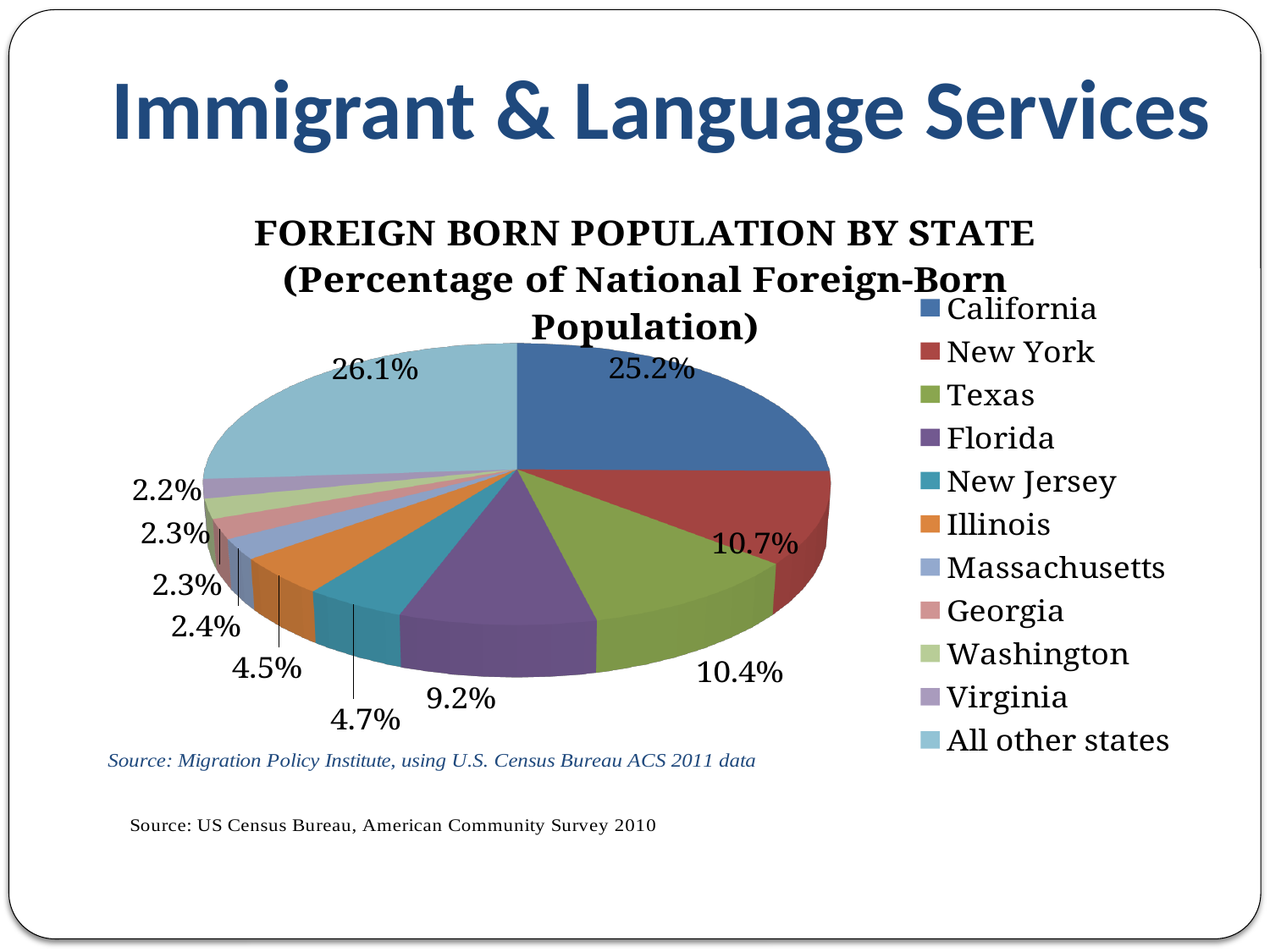
What is the combined share of New York and Texas? 21.1% What percentage is shown for All other states? 26.1% What is the difference between the percentages for California and New York? 14.5% Which has a larger share, New Jersey or Illinois? New Jersey How many categories are shown in the pie chart? 11 What type of chart is shown on the slide? Pie chart What is the value shown for Texas in the pie chart? 10.4% What share does Florida have in the Foreign Born Population by State pie chart? 9.2% What percentage of the national foreign-born population does California account for in the pie chart? 25.2% What is the title of the chart? FOREIGN BORN POPULATION BY STATE (Percentage of National Foreign-Born Population) Which state has the smallest slice in the pie chart? Virginia Which category has the largest slice in the pie chart? All other states